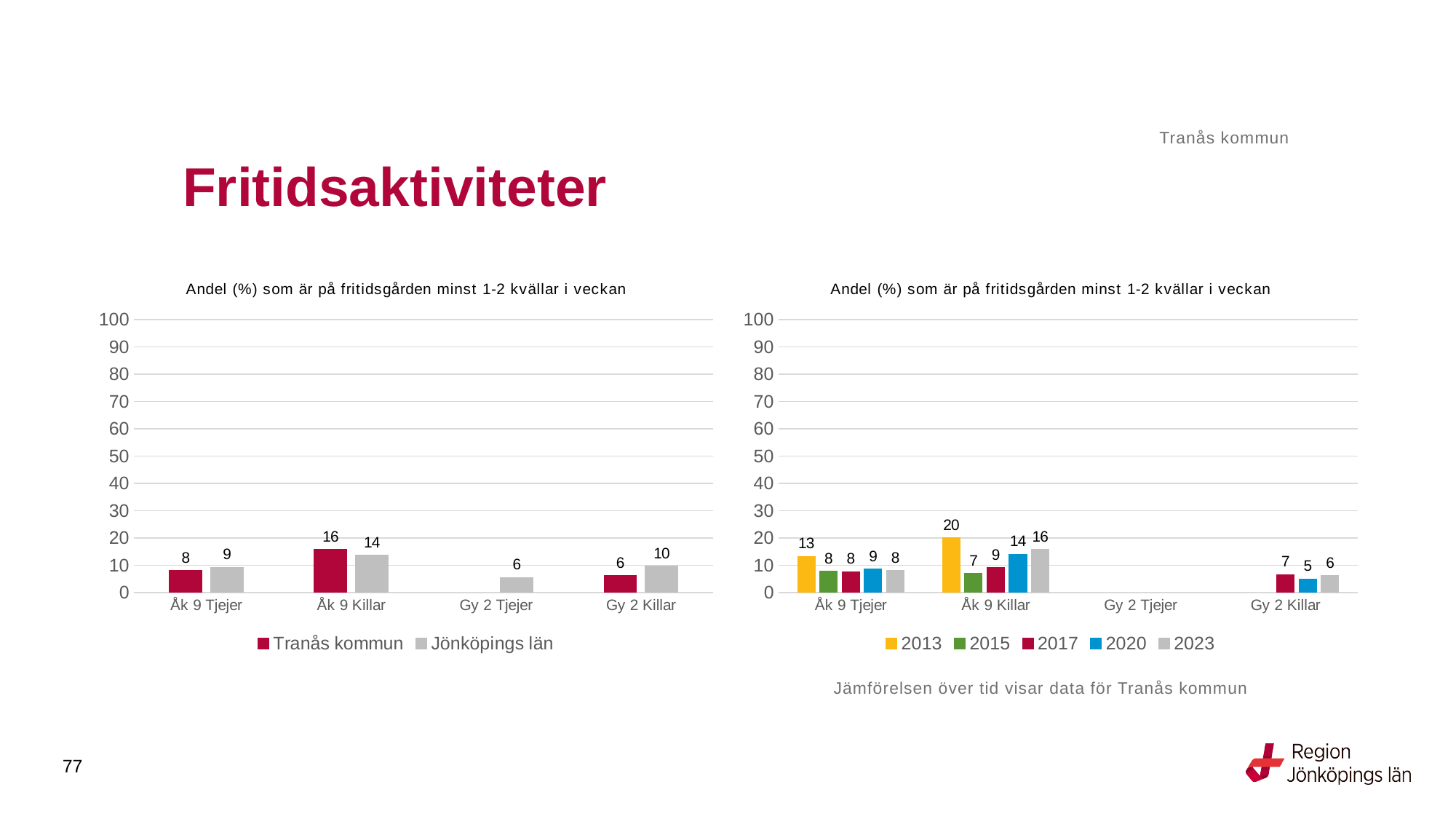
In the right chart, what is the difference between 2013 and 2023 for Åk 9 Killar? 4 What kind of chart is the left chart? Bar chart In the left chart, what is the value for Jönköpings län for Gy 2 Killar? 10 In the right chart, which year has the lowest value for Åk 9 Killar? 2015 In the left chart, what is the value for Tranås kommun for Åk 9 Killar? 16 In the left chart, which category has the highest value for Jönköpings län? Åk 9 Killar In the right chart, which is larger for Åk 9 Tjejer: 2013 or 2020? 2013 In the right chart, how many series does the legend list? 5 In the right chart, what is the value for 2013 for Åk 9 Killar? 20 In the right chart, what is the value for 2020 for Gy 2 Killar? 5 In the left chart, what is the difference between Tranås kommun and Jönköpings län for Gy 2 Killar? 4 In the left chart, how many series does the legend list? 2